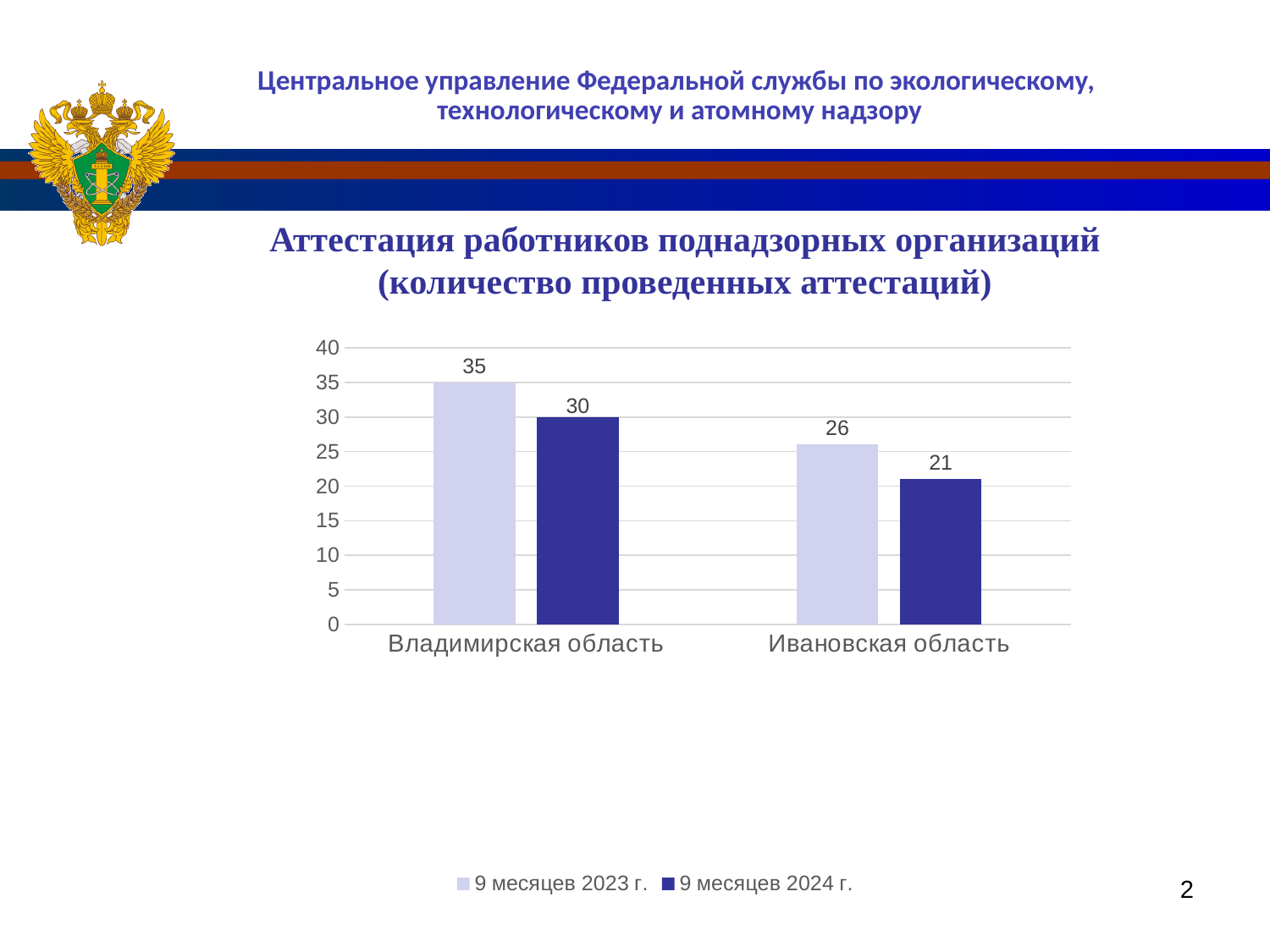
Which is larger: the 9 месяцев 2024 г. value for Владимирская область or the 9 месяцев 2023 г. value for Ивановская область? Владимирская область (9 месяцев 2024 г.) What is the value for Ивановская область in the 9 месяцев 2024 г. series? 21 How many categories are shown on the x axis? 2 What is the difference between the 9 месяцев 2023 г. and 9 месяцев 2024 г. values for Владимирская область? 5 What is the value for Владимирская область in the 9 месяцев 2024 г. series? 30 How many series does the legend list? 2 Which category has the highest value in the 9 месяцев 2023 г. series? Владимирская область Which category has the lowest value in the 9 месяцев 2024 г. series? Ивановская область What is the title of the chart? Аттестация работников поднадзорных организаций (количество проведенных аттестаций) What is the value for Владимирская область in the 9 месяцев 2023 г. series? 35 What kind of chart is shown on the slide? Bar chart What is the difference between the 9 месяцев 2023 г. and 9 месяцев 2024 г. values for Ивановская область? 5